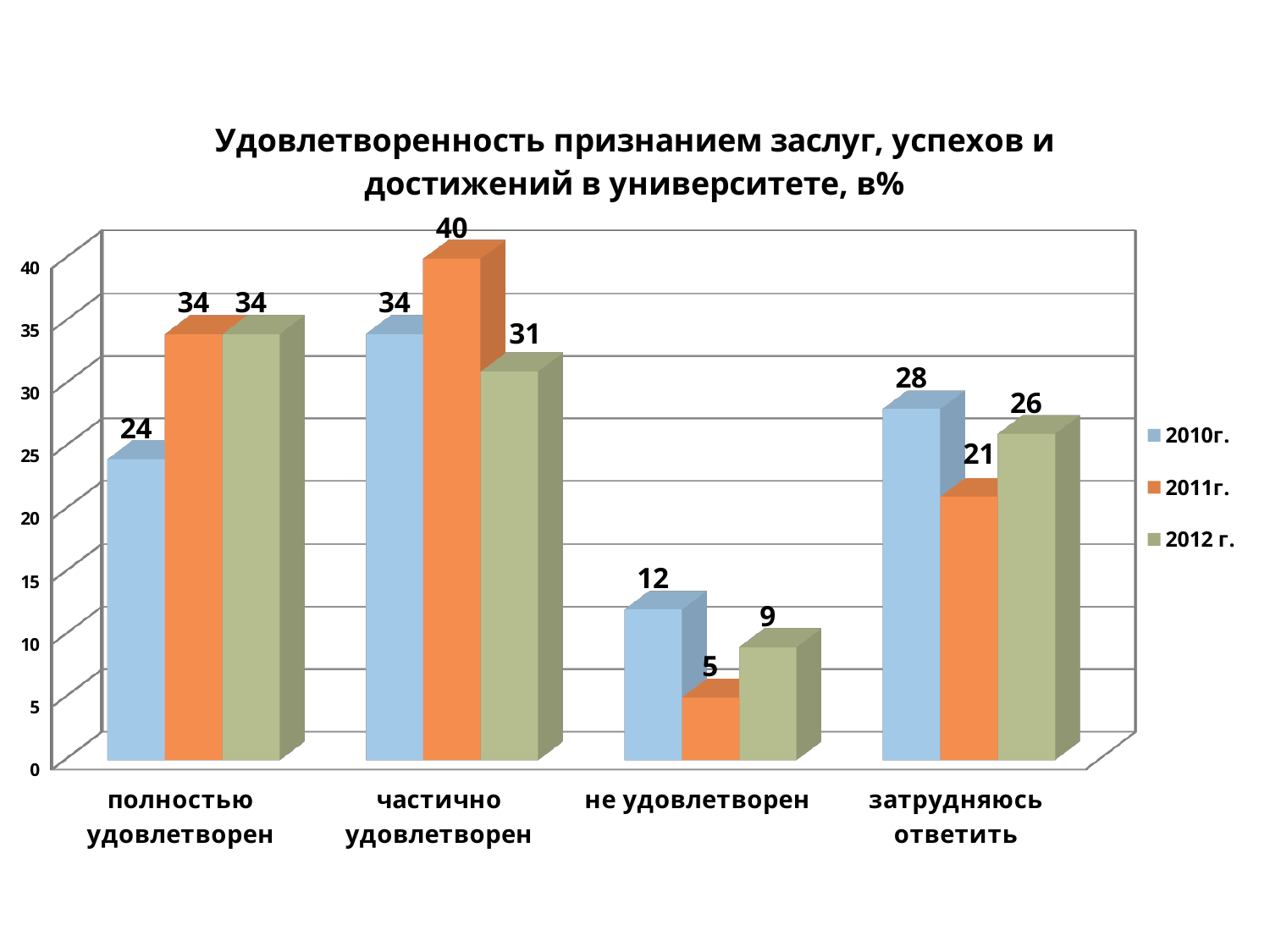
How many categories are shown on the x axis? 4 What is the difference between the 2011г. and 2012 г. values in the 'частично удовлетворен' category? 9 How many series does the legend list? 3 What is the value for 2011г. in the 'частично удовлетворен' category? 40 Which is larger in the 'затрудняюсь ответить' category: the 2010г. value or the 2012 г. value? 2010г. Which category has the highest value for the 2011г. series? частично удовлетворен What kind of chart is shown on the slide? bar chart Which category has the lowest value for the 2010г. series? не удовлетворен What is the value for 2012 г. in the 'не удовлетворен' category? 9 What is the value for 2011г. in the 'затрудняюсь ответить' category? 21 What is the value for 2010г. in the 'полностью удовлетворен' category? 24 What is the title of the chart? Удовлетворенность признанием заслуг, успехов и достижений в университете, в%